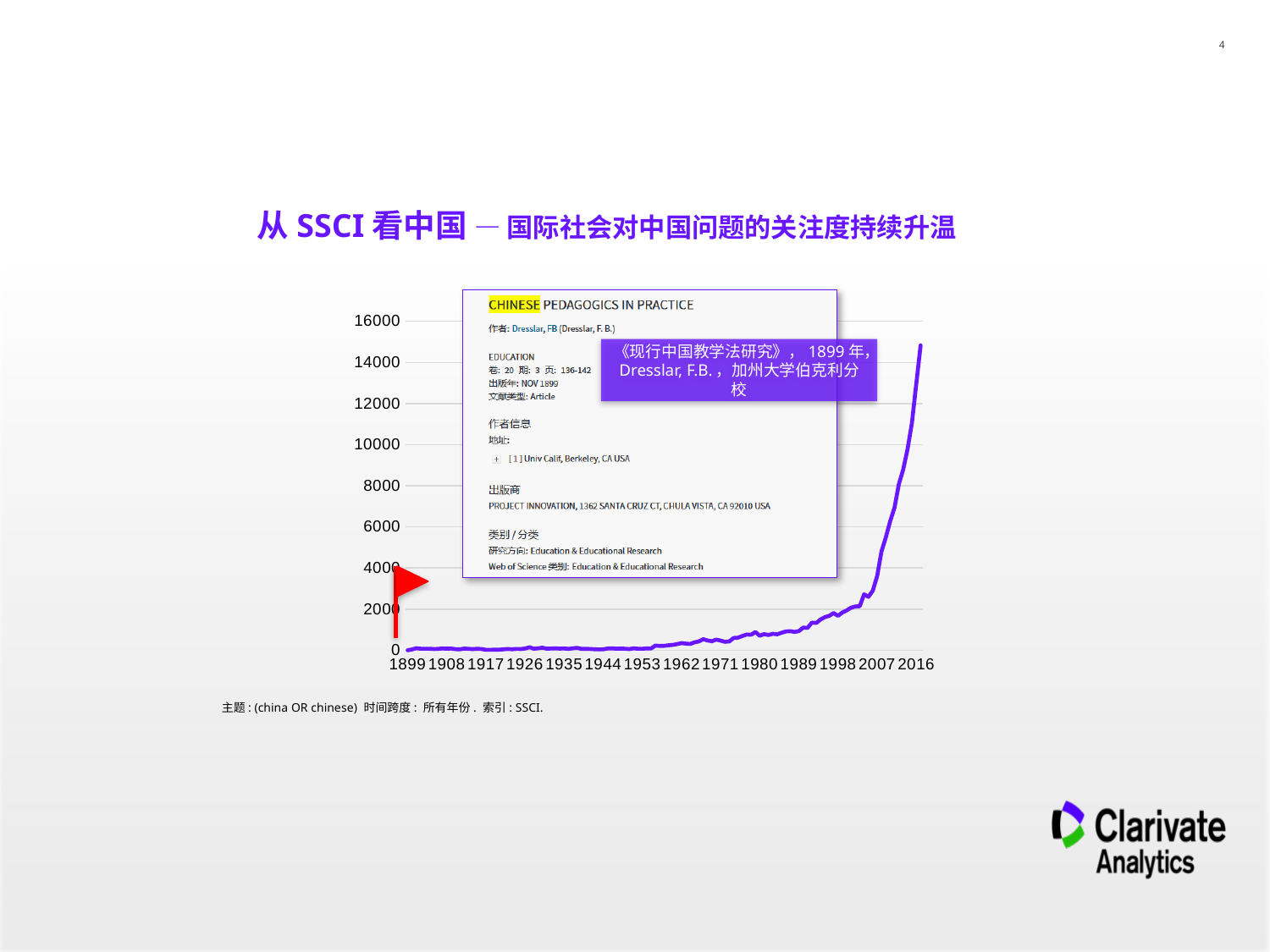
Is the value for 1899 greater or less than 2000? less Which has the larger value, 2016 or 1998? 2016 Do the values on the chart generally rise or fall from 1899 to 2016? rise Is the value for 1953 greater or less than 2000? less Is the value for 1980 greater or less than 2000? less What kind of chart is shown on the slide? line chart What is the first year labelled on the x axis? 1899 How many year labels are shown on the x axis? 14 Which year on the x axis has the highest value on the chart? 2016 What is the highest value labelled on the y axis? 16000